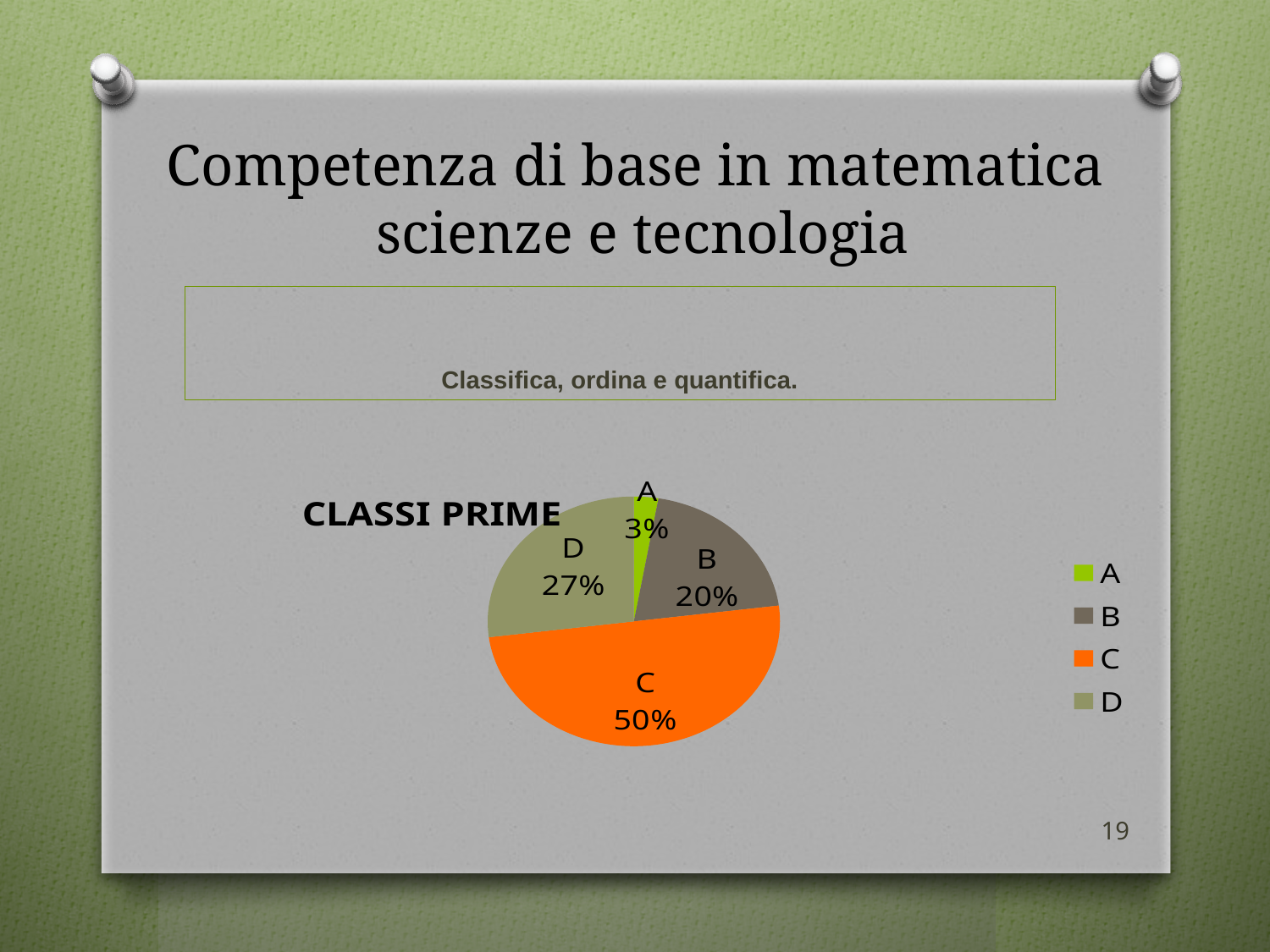
What is the title of the chart? CLASSI PRIME Which is larger, slice B or slice D? D What kind of chart is shown on the slide? pie chart What is the difference in percentage points between slice C and slice D? 23 What share of the pie does slice C represent? 50% How many entries does the legend list? 4 Which slice is the largest? C How many slices does the pie chart have? 4 Which slice is the smallest? A What share of the pie does slice A represent? 3% What share of the pie does slice B represent? 20%